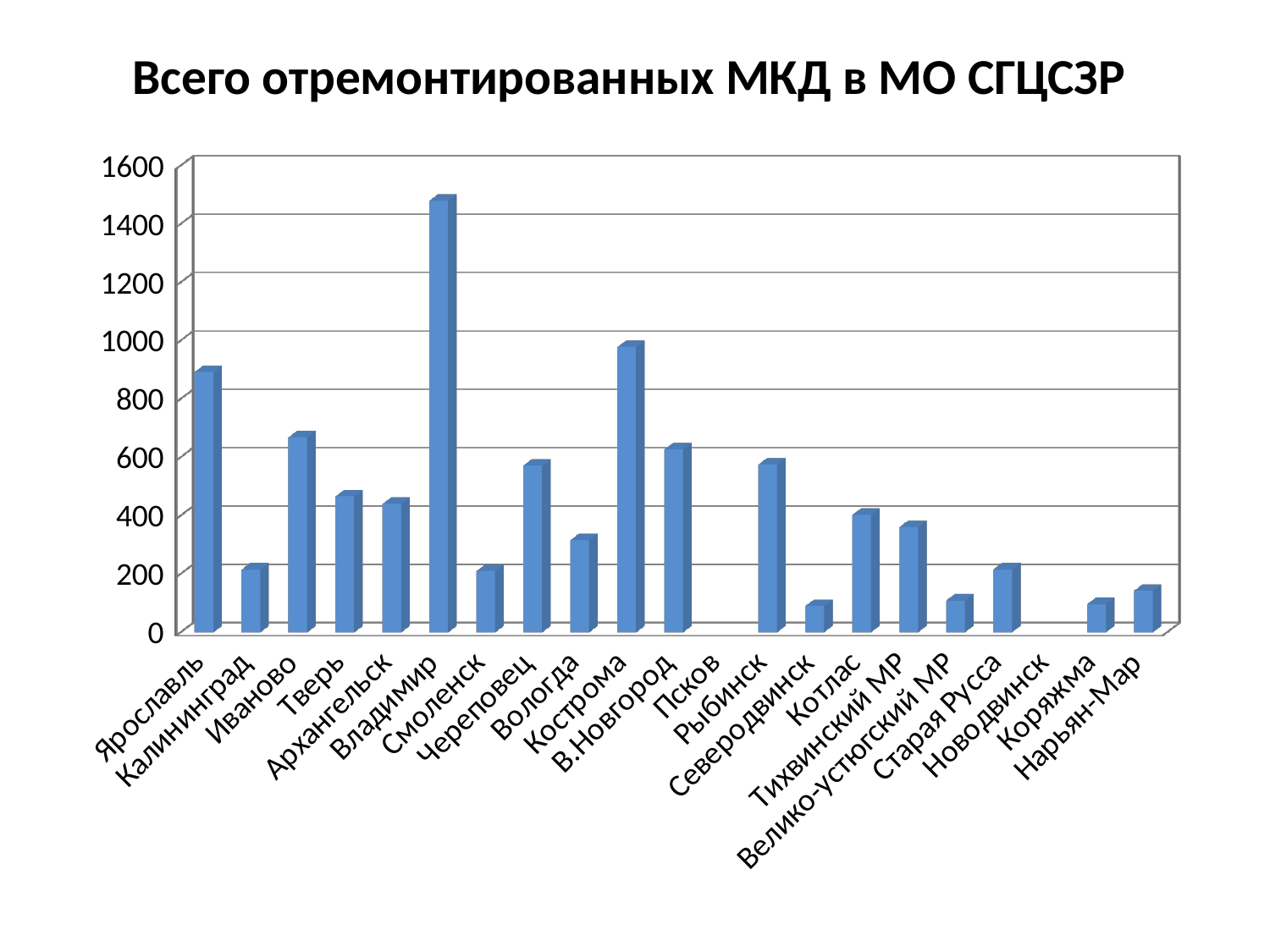
Which category has the highest bar in the chart? Владимир Is the value for Северодвинск greater or less than 200? less Which is larger, the value for Кострома or the value for Ярославль? Кострома Is the value for Котлас greater or less than 600? less What kind of chart is shown on the slide? bar chart What colour are the bars in the chart? blue Is the value for Калининград greater or less than 400? less Which is larger, the value for Иваново or the value for Тверь? Иваново How many categories are shown on the x axis of the chart? 21 What is the title of the chart? Всего отремонтированных МКД в МО СГЦСЗР